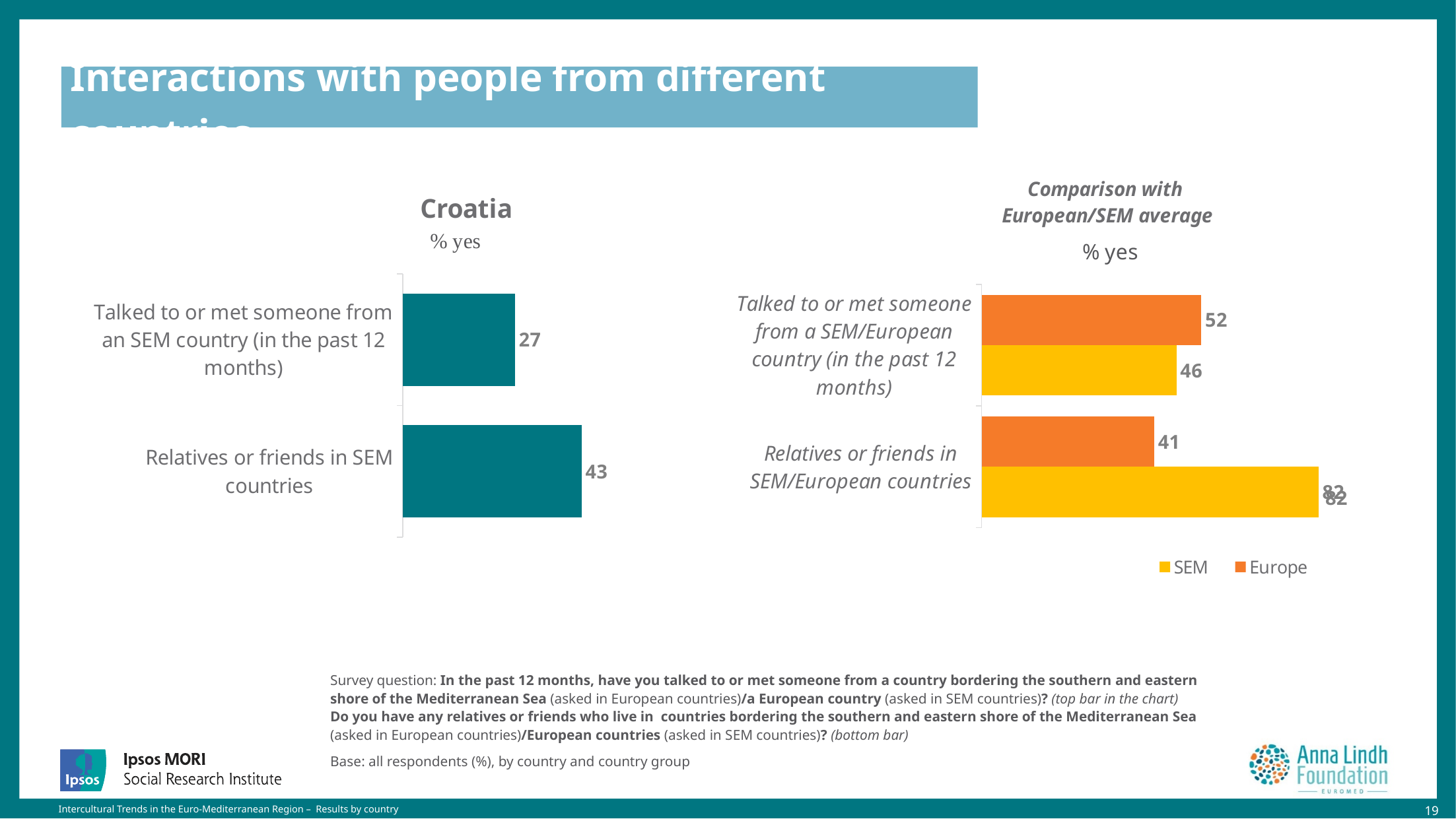
How many series does the legend of the Comparison with European/SEM average chart list? 2 In the Comparison with European/SEM average chart, what is the Europe value for relatives or friends in SEM/European countries? 41 In the Comparison with European/SEM average chart, what colour represents the Europe series? Orange In the Croatia chart, what percentage said they have relatives or friends in SEM countries? 43 In the Croatia chart, which category has the higher value? Relatives or friends in SEM countries In the Comparison with European/SEM average chart, what is the Europe value for talked to or met someone from a SEM/European country? 52 In the Comparison with European/SEM average chart, which series has the larger value for relatives or friends in SEM/European countries, SEM or Europe? SEM What type of chart is the Croatia chart? Bar chart In the Comparison with European/SEM average chart, what is the SEM value for talked to or met someone from a SEM/European country? 46 How many categories are shown in the Croatia chart? 2 In the Croatia chart, what is the difference between the two bars? 16 In the Croatia chart, what percentage said they talked to or met someone from an SEM country in the past 12 months? 27